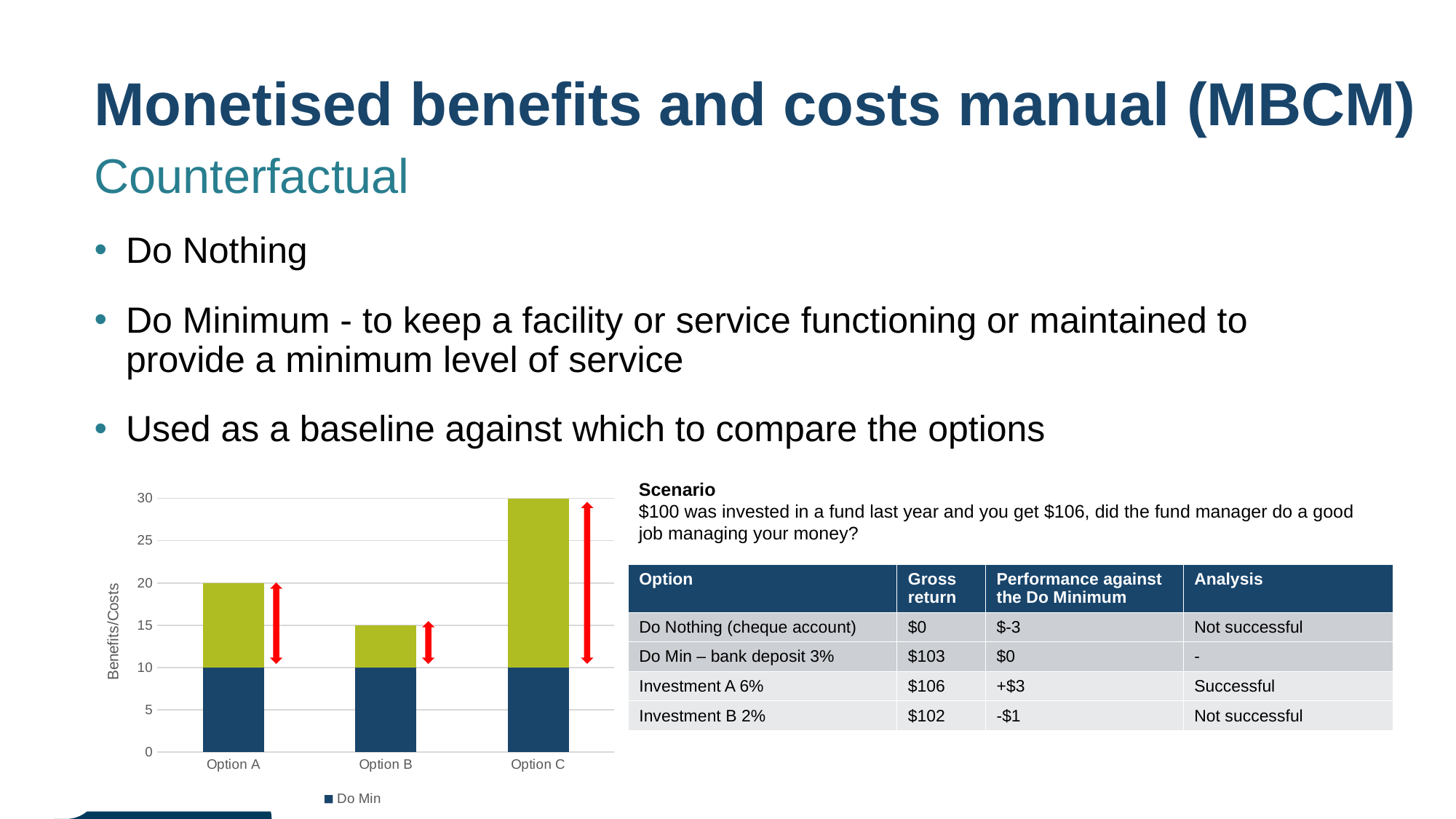
Is the total for Option C greater or less than 25? greater Which option has the tallest stacked bar in the chart? Option C What is the difference between the total for Option C and the total for Option A? 10 Which option has the shortest stacked bar in the chart? Option B How many options (categories) are shown on the x axis of the chart? 3 Which has a taller stacked bar, Option A or Option B? Option A What is the value of the Do Min segment for Option A? 10 What is the total height of the stacked bar for Option B? 15 What kind of chart is shown on the slide? Bar chart What is the label on the y axis of the chart? Benefits/Costs Is the total for Option B greater or less than 20? less What is the total height of the stacked bar for Option C? 30